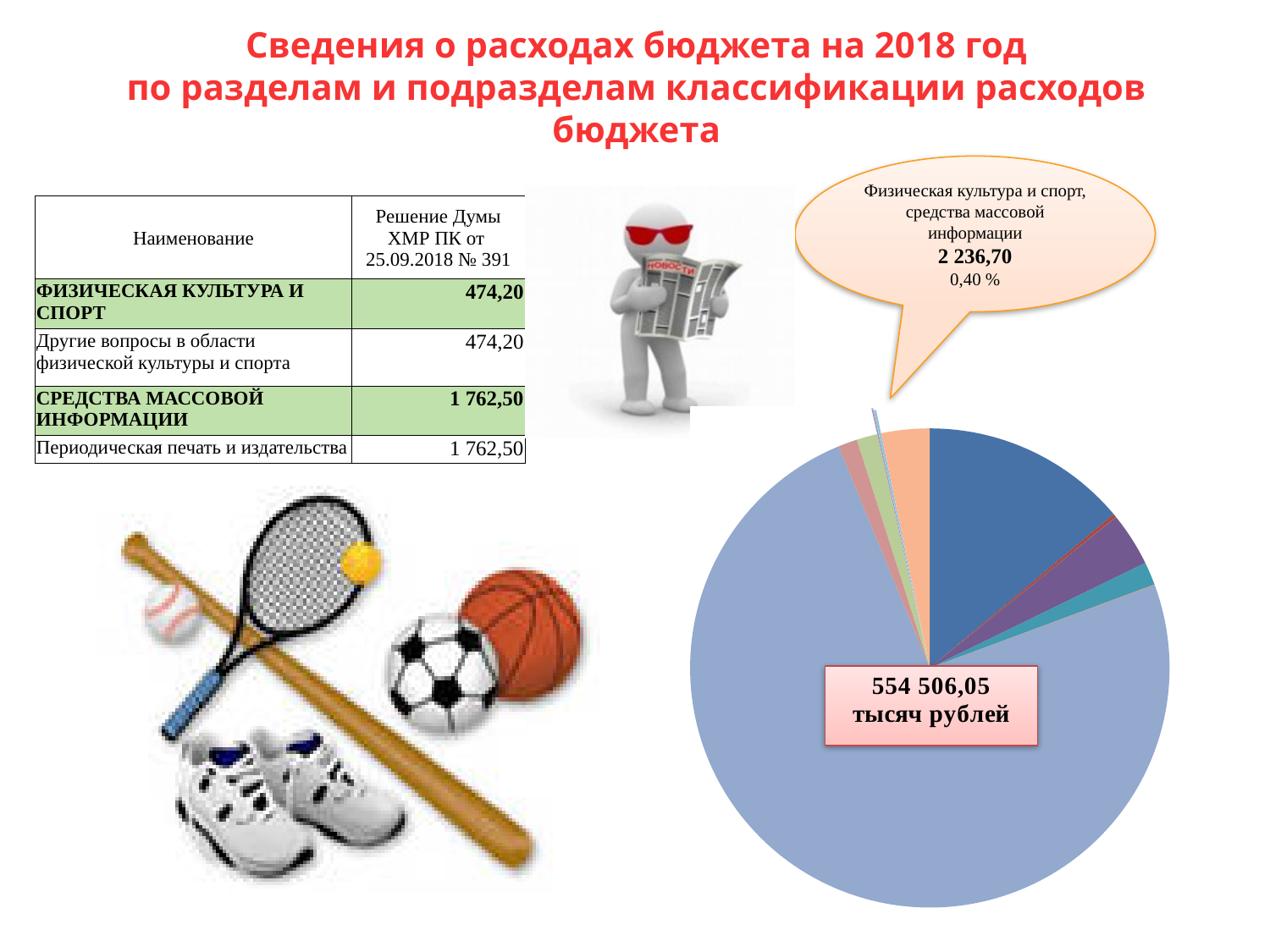
Which category does the callout on the pie chart point to? Физическая культура и спорт, средства массовой информации What total amount is shown in the box on the pie chart? 554 506,05 тысяч рублей According to the callout on the pie chart, what share of the pie does "Физическая культура и спорт, средства массовой информации" represent? 0,40 % What kind of chart is shown on the right side of the slide? pie chart Does the pie chart have a legend listing its categories? No According to the callout on the pie chart, what is the value for "Физическая культура и спорт, средства массовой информации"? 2 236,70